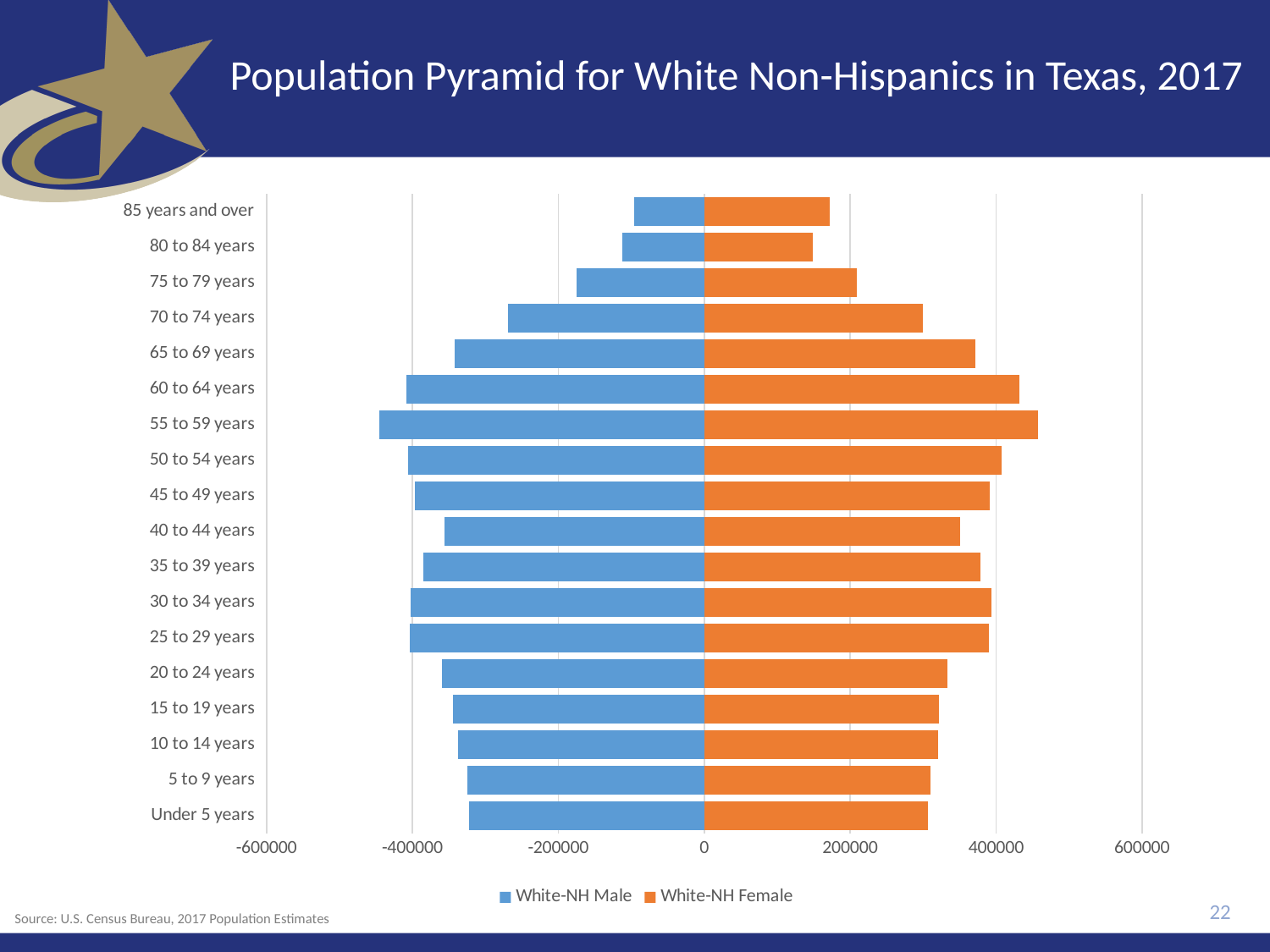
How many series does the legend list? 2 Is the White-NH Female value for 55 to 59 years greater or less than 400000? greater What is the title of the chart? Population Pyramid for White Non-Hispanics in Texas, 2017 How many age groups are plotted on the chart? 18 Which is larger, the White-NH Female value for 65 to 69 years or for 75 to 79 years? 65 to 69 years Is the White-NH Female value for 40 to 44 years greater or less than 400000? less Which age group has the longest White-NH Male bar? 55 to 59 years Which colour represents White-NH Female in the chart? orange What kind of chart is shown on the slide? bar chart Is the White-NH Female value for 85 years and over greater or less than 200000? less Which age group has the longest White-NH Female bar? 55 to 59 years